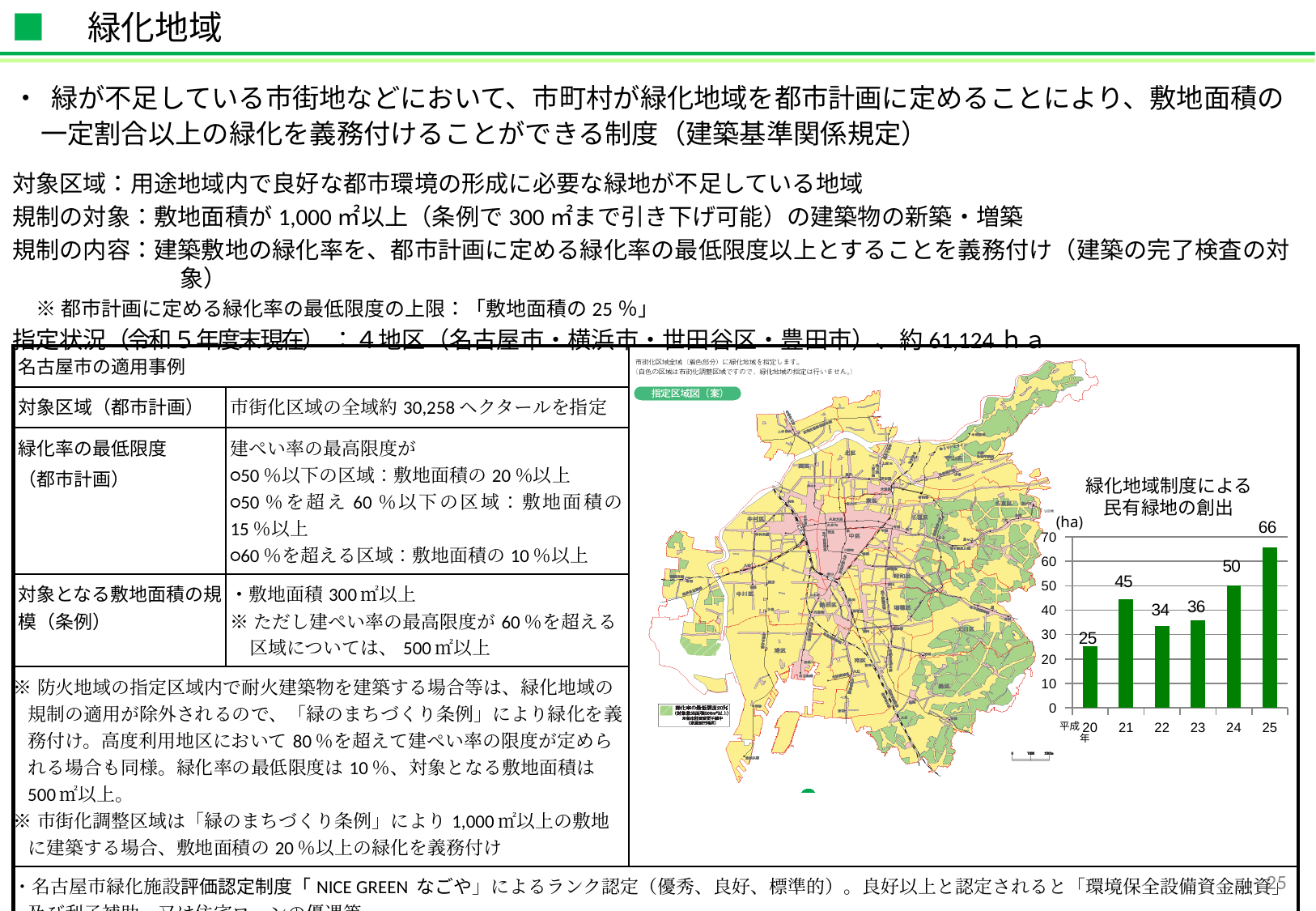
In the chart 緑化地域制度による民有緑地の創出, which is larger, the value for 平成21年 or 平成22年? 平成21年 How many bars are plotted in the chart 緑化地域制度による民有緑地の創出? 6 In the chart 緑化地域制度による民有緑地の創出, what is the difference between the values for 平成21年 and 平成22年? 11 In the chart 緑化地域制度による民有緑地の創出, what is the value for 平成20年? 25 What unit is shown on the y axis of the chart 緑化地域制度による民有緑地の創出? ha In the chart 緑化地域制度による民有緑地の創出, which year has the highest value? 平成25年 What type of chart is shown under the title 緑化地域制度による民有緑地の創出? bar chart In the chart 緑化地域制度による民有緑地の創出, what is the value for 平成23年? 36 In the chart 緑化地域制度による民有緑地の創出, what is the difference between the values for 平成25年 and 平成24年? 16 In the chart 緑化地域制度による民有緑地の創出, which year has the lowest value? 平成20年 In the chart 緑化地域制度による民有緑地の創出, what is the value for 平成25年? 66 In the chart 緑化地域制度による民有緑地の創出, is the value for 平成24年 greater or less than 40? greater